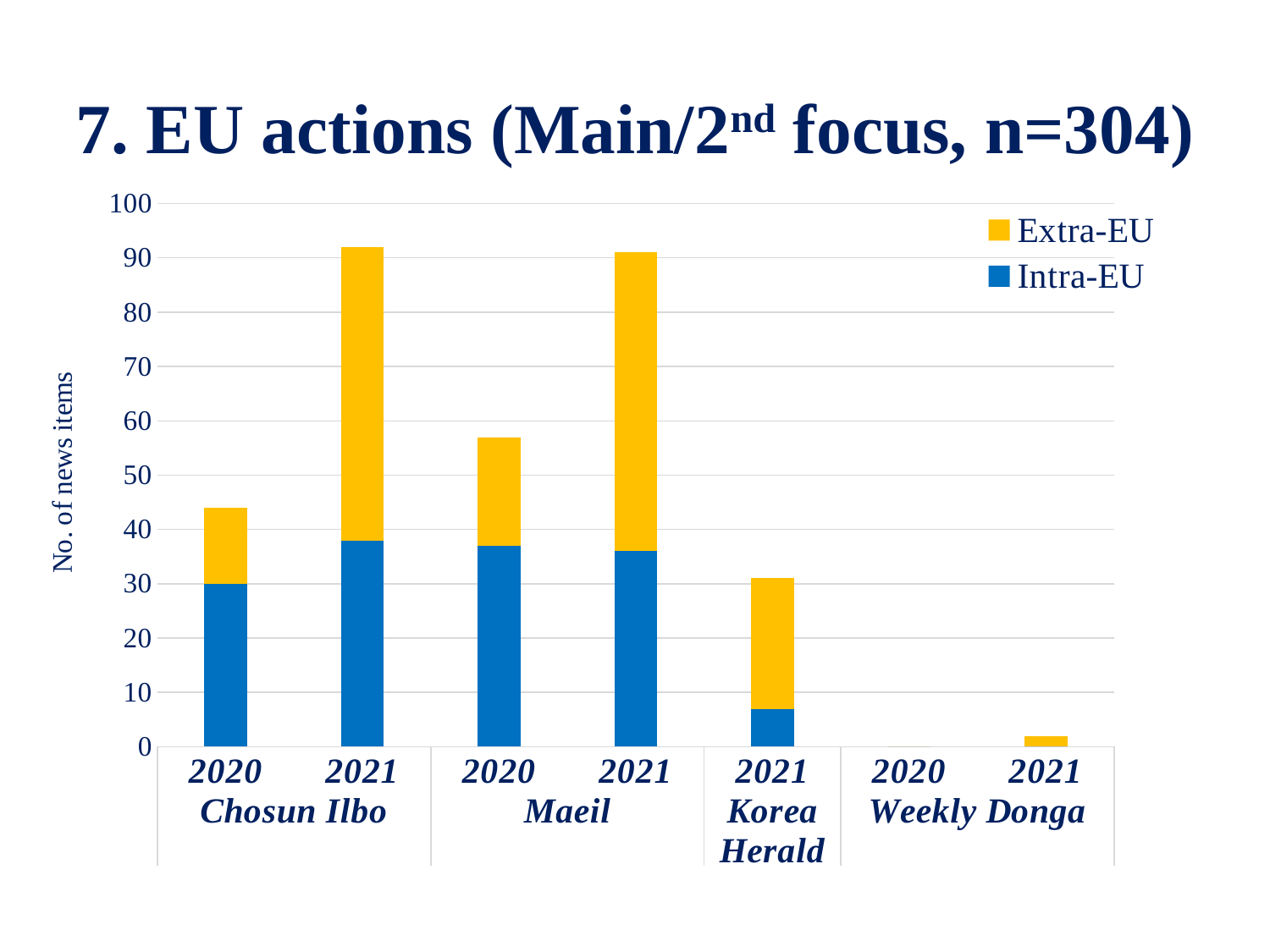
What kind of chart is shown on the slide? stacked bar chart Is the total value for 2020 Maeil greater or less than 50? greater Which category has the lowest total number of news items? 2020 Weekly Donga How many series does the legend list? 2 Is the Intra-EU value for 2021 Korea Herald greater or less than 10? less Which has the larger total number of news items, 2020 Maeil or 2020 Chosun Ilbo? 2020 Maeil What is the label on the y axis? No. of news items Is the total value for 2021 Weekly Donga greater or less than 10? less Which has the larger total number of news items, 2021 Korea Herald or 2020 Chosun Ilbo? 2020 Chosun Ilbo For Chosun Ilbo, does the total number of news items rise or fall from 2020 to 2021? rise How many bars (newspaper-year categories) are shown on the x axis? 7